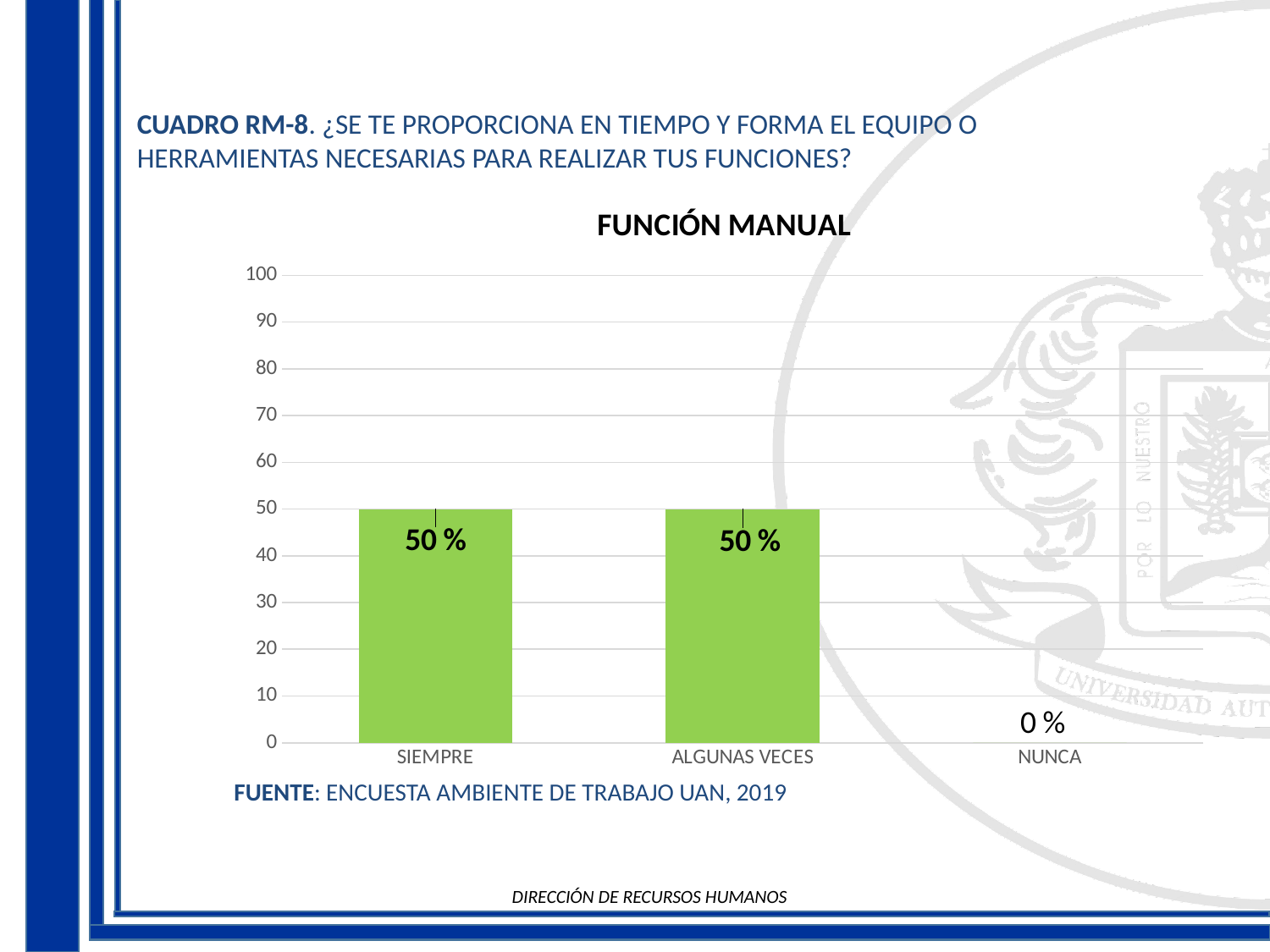
What is the value for NUNCA? 0 % What colour are the bars in the chart? green What is the value for SIEMPRE? 50 % What kind of chart is shown? bar chart What is the difference between the values for SIEMPRE and NUNCA? 50 % Which category has the lowest value? NUNCA What is the title of the chart? FUNCIÓN MANUAL What is the highest value shown on the y axis? 100 How many categories are shown on the x axis? 3 Which is larger, the value for ALGUNAS VECES or the value for NUNCA? ALGUNAS VECES Is the value for SIEMPRE greater or less than 80? less What is the value for ALGUNAS VECES? 50 %